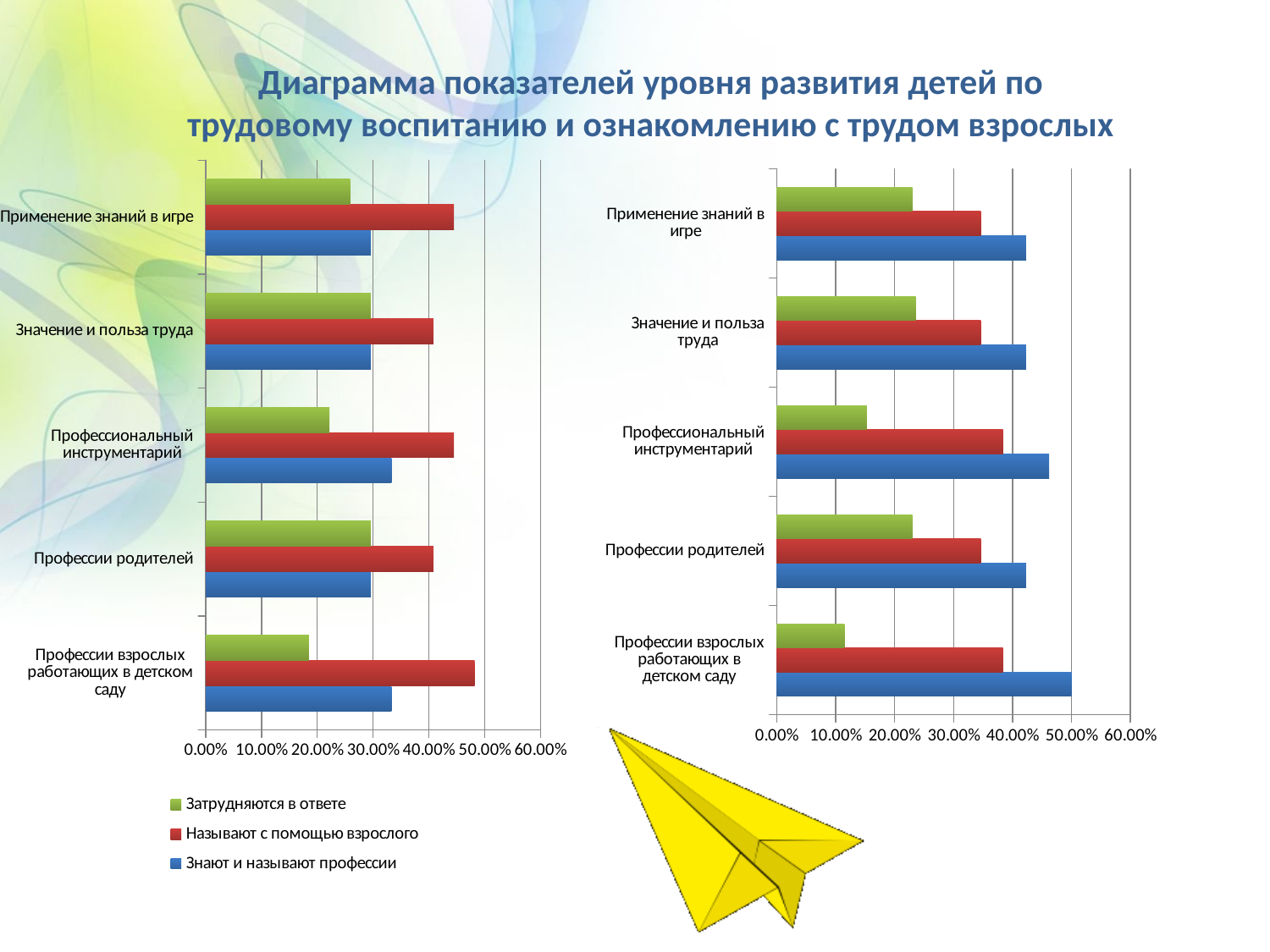
On the right chart, for 'Профессии родителей', which is larger: the blue bar or the green bar? the blue bar On the right chart, which category has the highest blue bar? Профессии взрослых работающих в детском саду What kind of chart is the left chart on the slide? bar chart How many categories are shown on the left chart? 5 How many categories are shown on the right chart? 5 On the left chart, for 'Применение знаний в игре', which is larger: 'Называют с помощью взрослого' or 'Затрудняются в ответе'? Называют с помощью взрослого How many series does the legend of the left chart list? 3 On the left chart, which series is shown in red according to the legend? Называют с помощью взрослого On the right chart, is the green bar for 'Профессиональный инструментарий' greater or less than 20.00%? less On the left chart, which category has the highest value for 'Называют с помощью взрослого'? Профессии взрослых работающих в детском саду On the left chart, is the value of 'Называют с помощью взрослого' for 'Профессии взрослых работающих в детском саду' greater or less than 40.00%? greater On the left chart, which category has the lowest value for 'Затрудняются в ответе'? Профессии взрослых работающих в детском саду